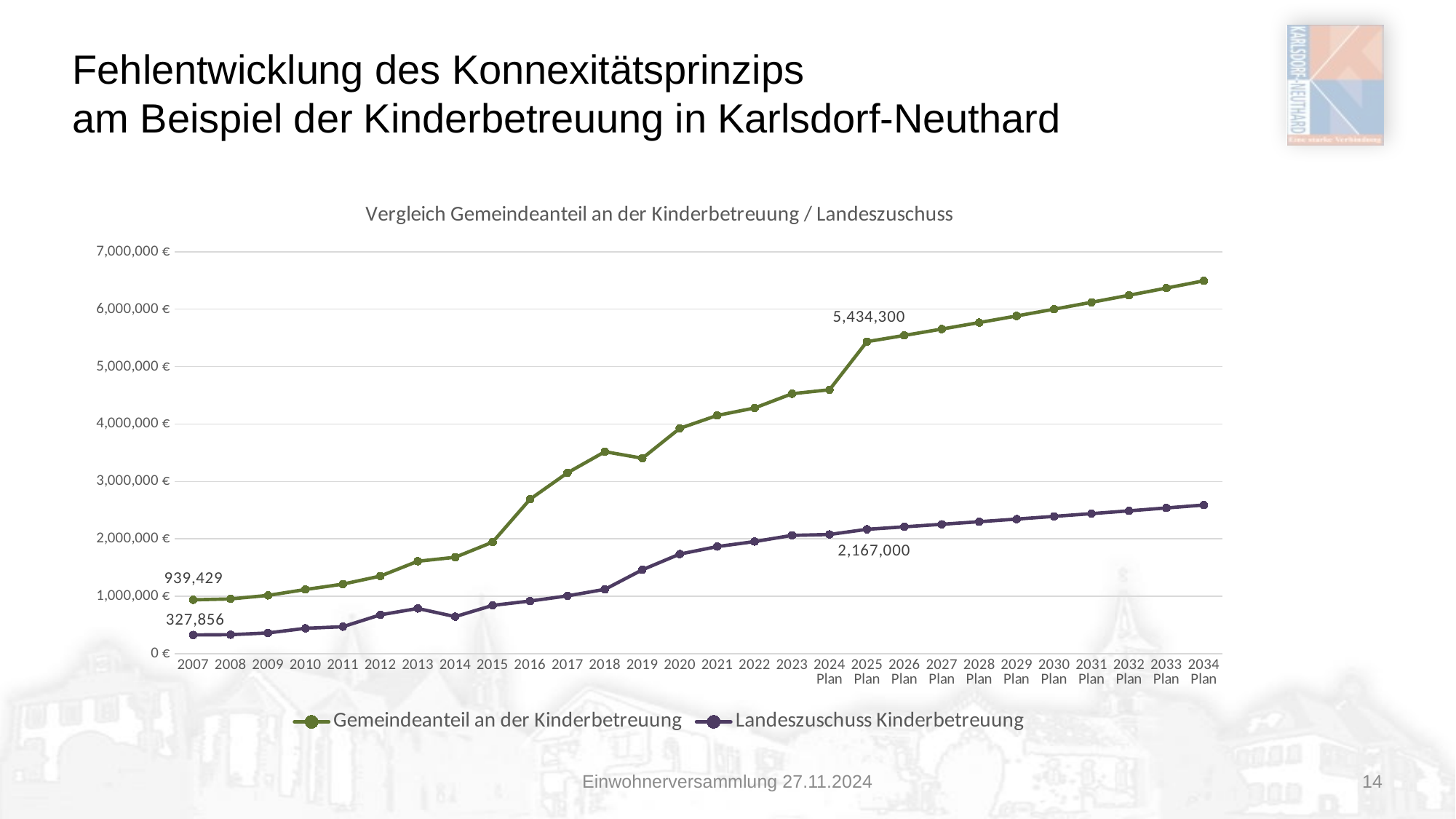
In which year does Gemeindeanteil an der Kinderbetreuung reach its highest value? 2034 Plan How many years are plotted along the x axis of the chart? 28 How many series does the chart legend list? 2 What is the difference between the labeled 2007 values of Gemeindeanteil an der Kinderbetreuung and Landeszuschuss Kinderbetreuung? 611,573 What type of chart is shown on the slide? line chart Do the values of Gemeindeanteil an der Kinderbetreuung generally rise or fall from 2007 to 2034 Plan? rise What is the title of the chart? Vergleich Gemeindeanteil an der Kinderbetreuung / Landeszuschuss What is the labeled value of Gemeindeanteil an der Kinderbetreuung in 2007? 939,429 What is the labeled value of Landeszuschuss Kinderbetreuung in 2007? 327,856 Is the value for Gemeindeanteil an der Kinderbetreuung in 2034 Plan greater or less than 6,000,000 €? greater Which series has the larger value in 2007, Gemeindeanteil an der Kinderbetreuung or Landeszuschuss Kinderbetreuung? Gemeindeanteil an der Kinderbetreuung Is the value for Landeszuschuss Kinderbetreuung in 2020 greater or less than 2,000,000 €? less